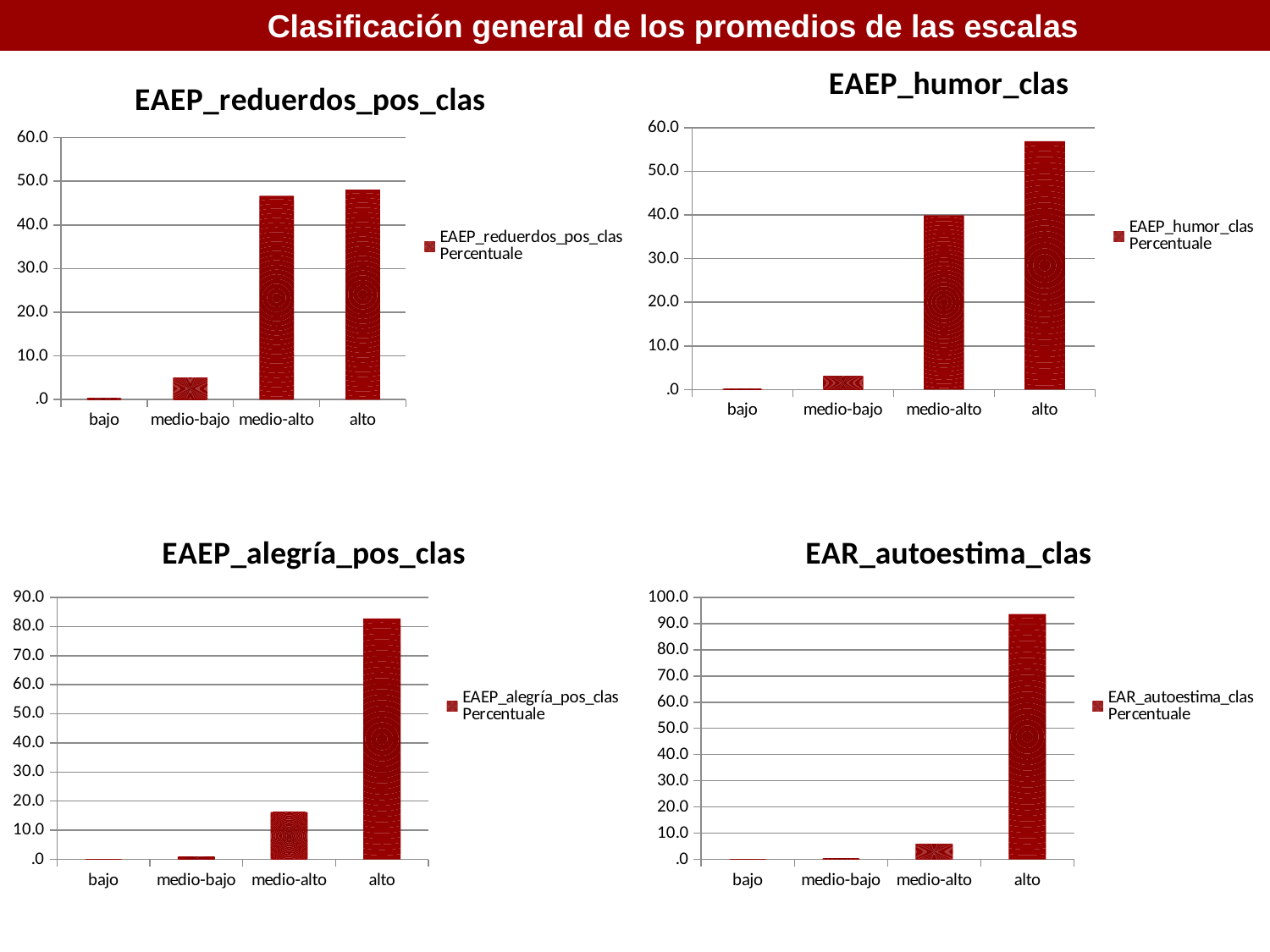
In the EAEP_humor_clas chart, which category has the highest value? alto How many categories are shown on the x axis of the EAR_autoestima_clas chart? 4 In the EAEP_alegría_pos_clas chart, is the value for alto greater or less than 80? greater In the EAR_autoestima_clas chart, is the value for medio-alto greater or less than 10? less In the EAEP_humor_clas chart, do the values rise or fall from bajo to alto? rise In the EAEP_reduerdos_pos_clas chart, which category has the lowest value? bajo In the EAEP_reduerdos_pos_clas chart, is the value for medio-bajo greater or less than 10? less What kind of chart is EAEP_humor_clas? bar chart In the EAR_autoestima_clas chart, which category has the highest value? alto In the EAEP_alegría_pos_clas chart, which is larger, the value for medio-alto or the value for alto? alto How many series does the legend of the EAEP_alegría_pos_clas chart list? 1